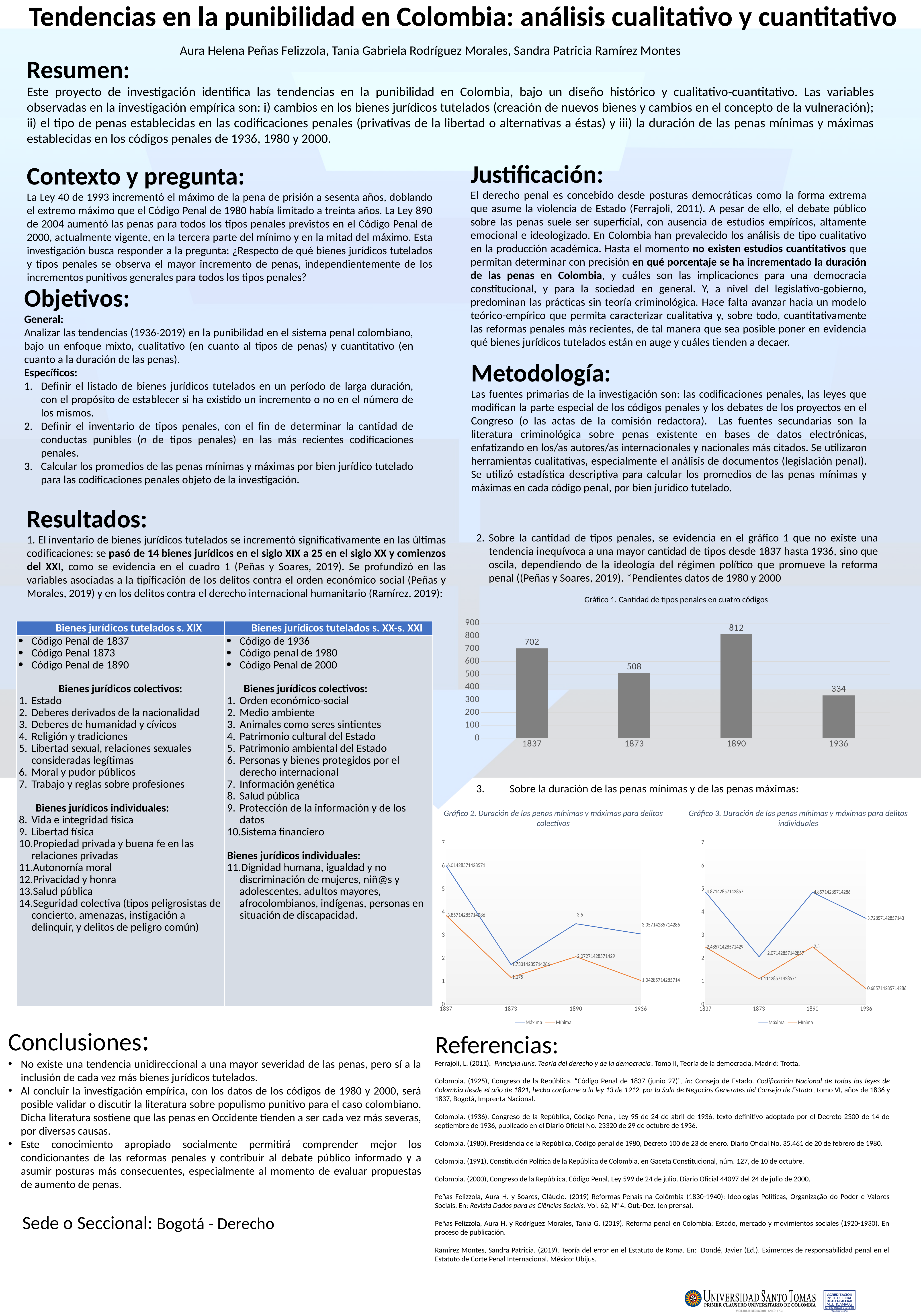
In Gráfico 1, what is the value for 1936? 334 In Gráfico 1, how many years (bars) are shown? 4 In Gráfico 1, which year has the lowest number of tipos penales? 1936 In Gráfico 3, what is the Mínima value for 1890? 2.5 How many series does the legend of Gráfico 3 list? 2 In Gráfico 2, what is the Máxima value for 1890? 3.5 In Gráfico 1, what is the value for 1890? 812 In Gráfico 1, what is the difference between the values for 1837 and 1873? 194 In Gráfico 2, what is the Mínima value for 1873? 1.175 What kind of chart is Gráfico 1? Bar chart In Gráfico 1, which year has the highest number of tipos penales? 1890 In Gráfico 1, which is larger, the value for 1837 or the value for 1890? 1890